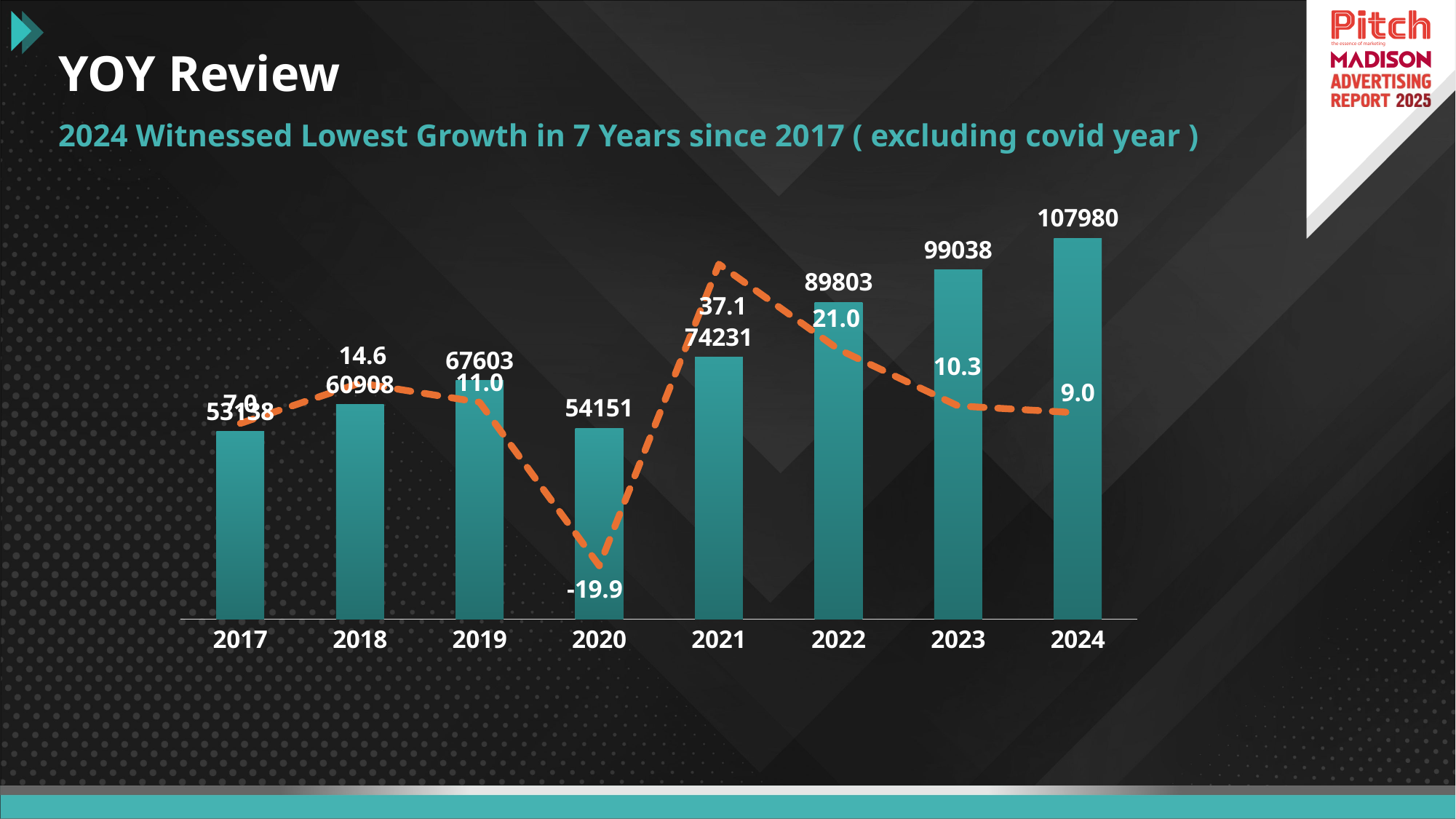
What growth value does the dashed line show for 2020? -19.9 What is the difference between the growth values for 2022 and 2023? 10.7 Do the bar values rise or fall from 2021 to 2024? Rise Which is larger, the bar value for 2019 or for 2020? 2019 What growth value does the dashed line show for 2021? 37.1 Which year has the lowest growth value on the dashed line? 2020 Which year has the highest bar value? 2024 What is the bar value for 2024? 107980 What is the bar value for 2020? 54151 What is the difference between the bar values for 2024 and 2023? 8942 How many years are shown on the x axis? 8 What kind of chart is this? Bar chart with a line